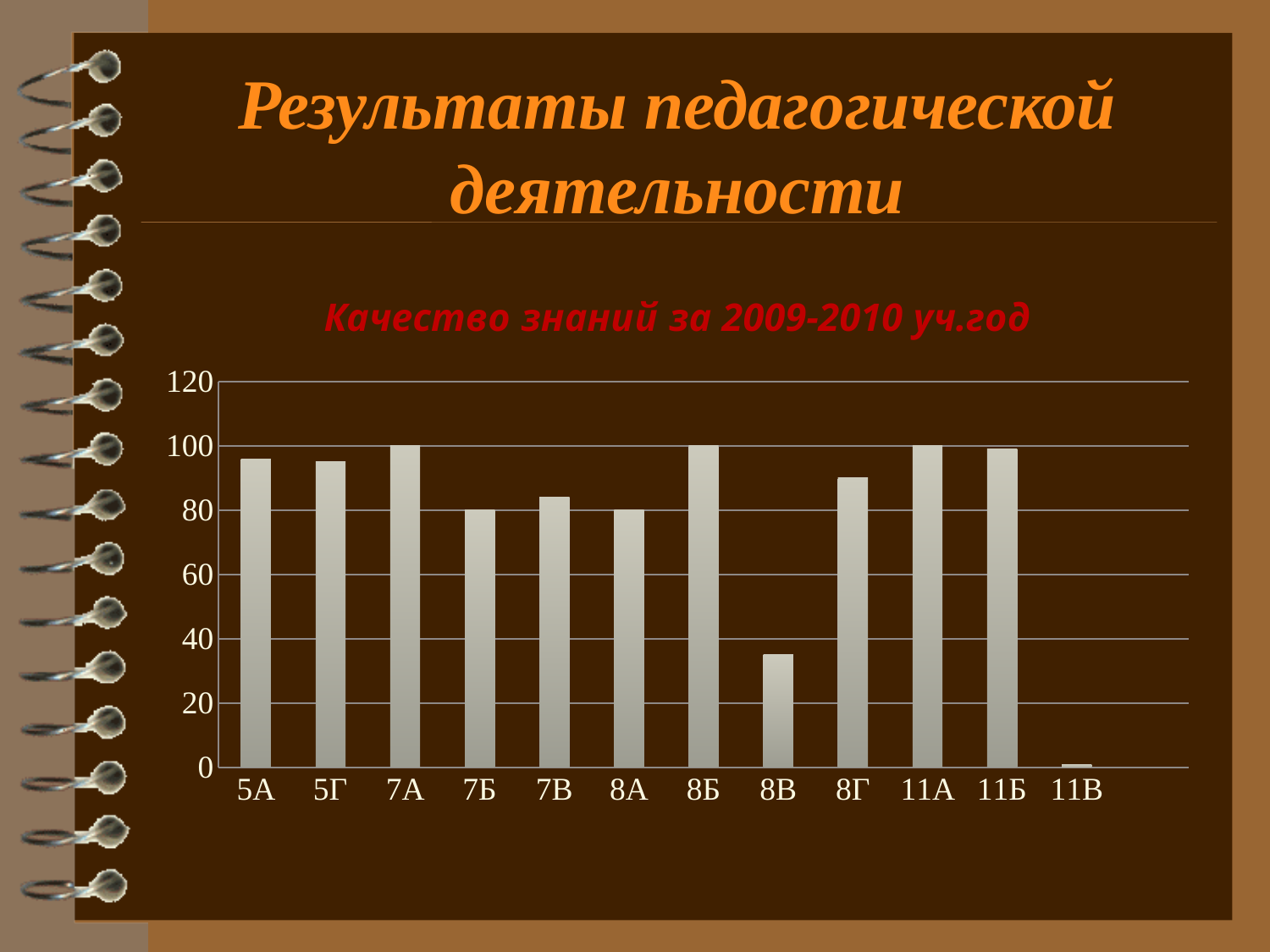
How many classes (categories) are shown on the x axis of the chart? 12 Which has the larger value, 8В or 8Г? 8Г What is the difference between the values for 7А and 7Б? 20 Is the value for 8Г greater or less than 80? greater Is the value for 8В greater or less than 40? less What is the title of the chart? Качество знаний за 2009-2010 уч.год Which class has the lowest value in the chart? 11В What is the value for 7Б? 80 What is the value for 7А? 100 What is the value for 8А? 80 What kind of chart is shown on the slide? bar chart What is the value for 8Б? 100